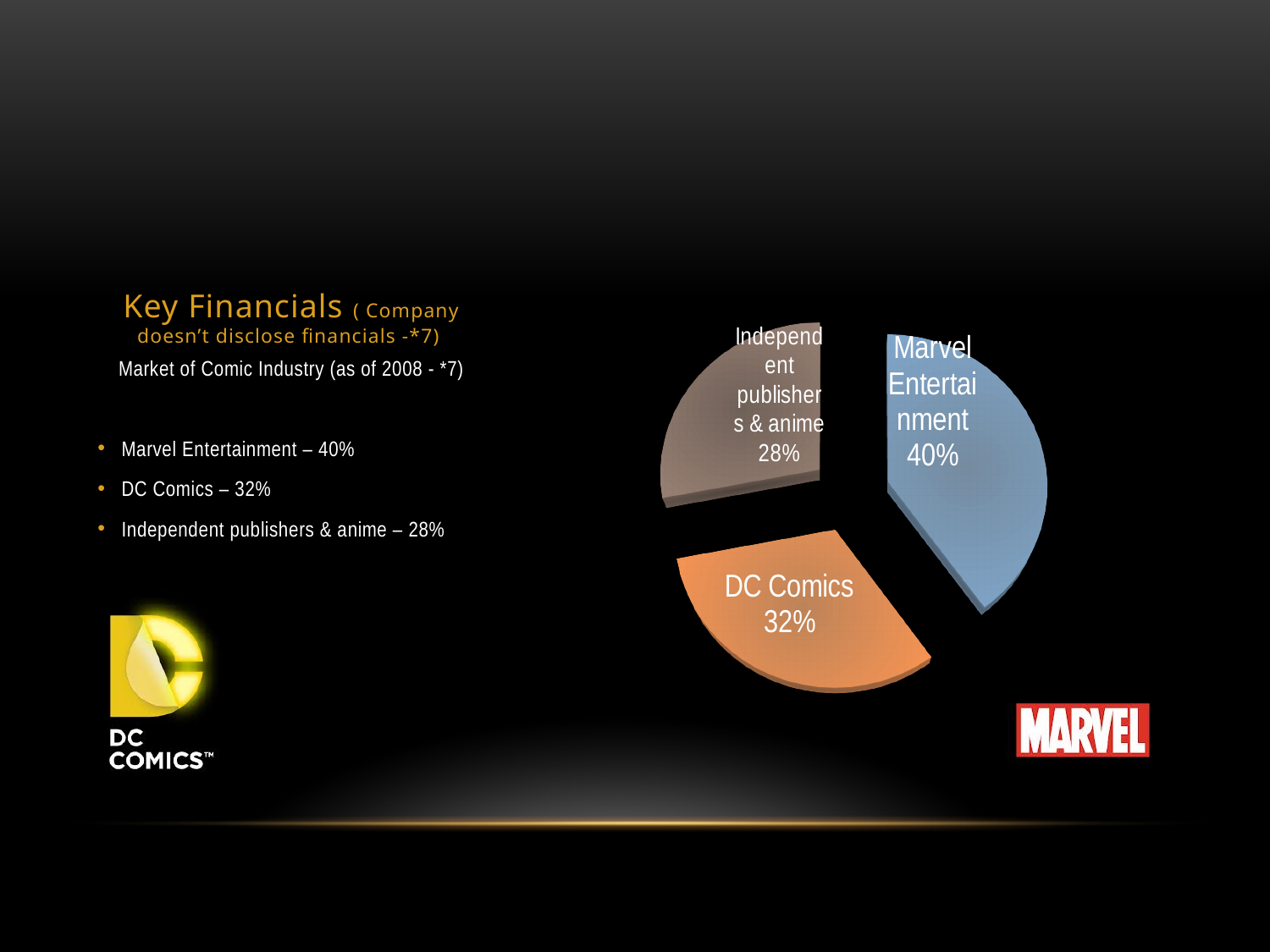
What colour is the Marvel Entertainment slice in the pie chart? blue Which slice of the pie chart is the largest? Marvel Entertainment What colour is the DC Comics slice in the pie chart? orange What kind of chart is shown on the slide? pie chart What is the difference in percentage points between Marvel Entertainment and DC Comics? 8 What share of the pie does DC Comics hold? 32% How many slices does the pie chart have? 3 What share of the pie does Marvel Entertainment hold? 40% Which is larger, the DC Comics slice or the Independent publishers & anime slice? DC Comics Which slice of the pie chart is the smallest? Independent publishers & anime What share of the pie do Independent publishers & anime hold? 28% What is the difference in percentage points between DC Comics and Independent publishers & anime? 4